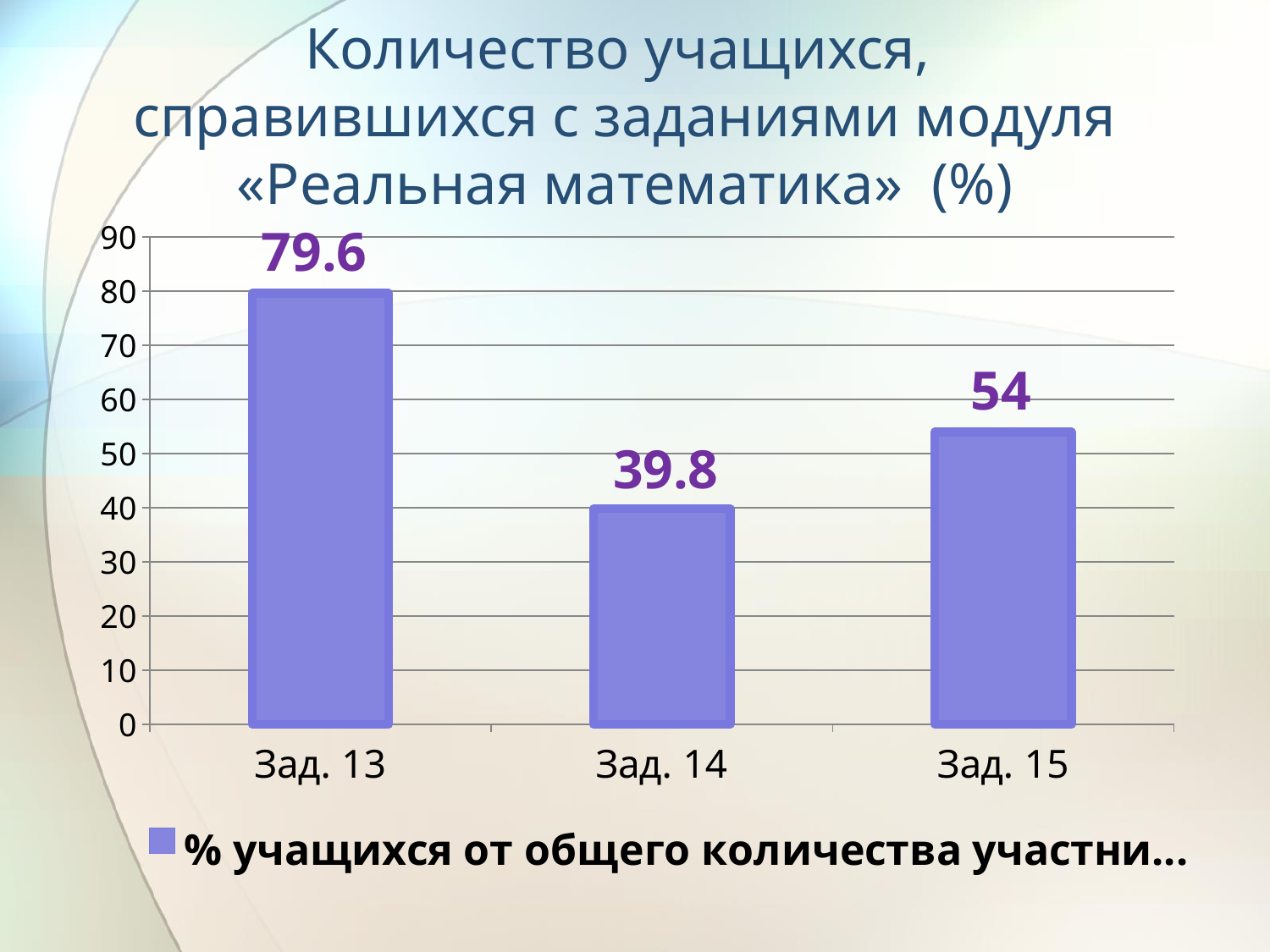
What is the difference between the values for Зад. 15 and Зад. 14? 14.2 How many categories are shown on the x axis? 3 Is the value for Зад. 15 greater or less than 50? greater What is the value for Зад. 14? 39.8 Which category has the highest value? Зад. 13 Which is larger, the value for Зад. 15 or the value for Зад. 14? Зад. 15 What is the value for Зад. 15? 54 What kind of chart is shown on the slide? bar chart Which category has the lowest value? Зад. 14 What is the difference between the values for Зад. 13 and Зад. 14? 39.8 What is the value for Зад. 13? 79.6 What is the maximum value shown on the vertical axis? 90